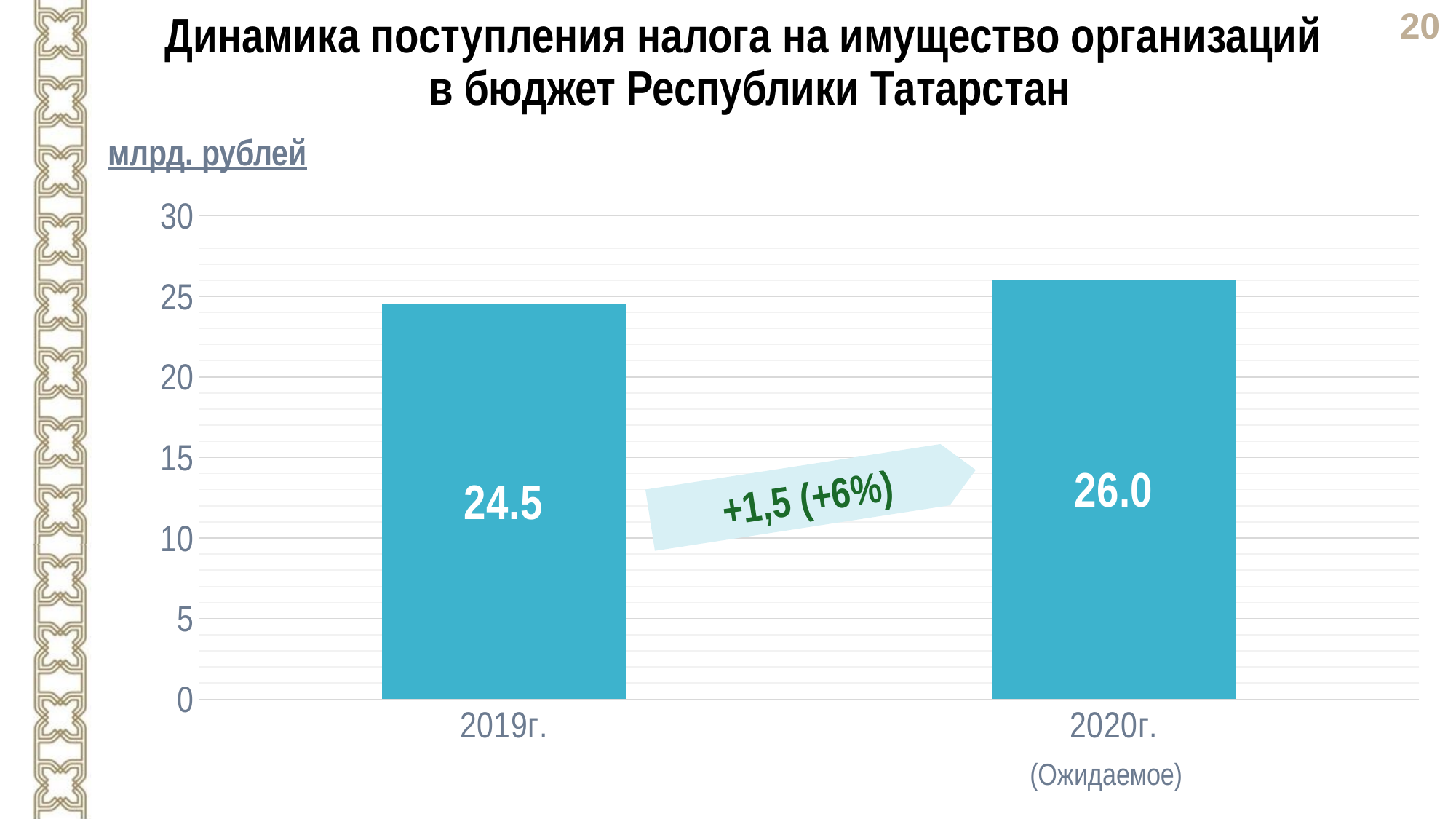
What is the value for 2019г.? 24.5 How many bars are shown in the chart? 2 What unit is indicated above the chart? млрд. рублей Do the values rise or fall from 2019г. to 2020г.? rise What is the value for 2020г. (Ожидаемое)? 26.0 What is the difference between the 2020г. value and the 2019г. value? 1.5 Which year has the higher value? 2020г. Is the value for 2019г. greater or less than 25? less What kind of chart is shown on the slide? bar chart Is the value for 2020г. greater or less than 25? greater Is the value for 2019г. larger or smaller than the value for 2020г.? smaller Which year has the lower value? 2019г.